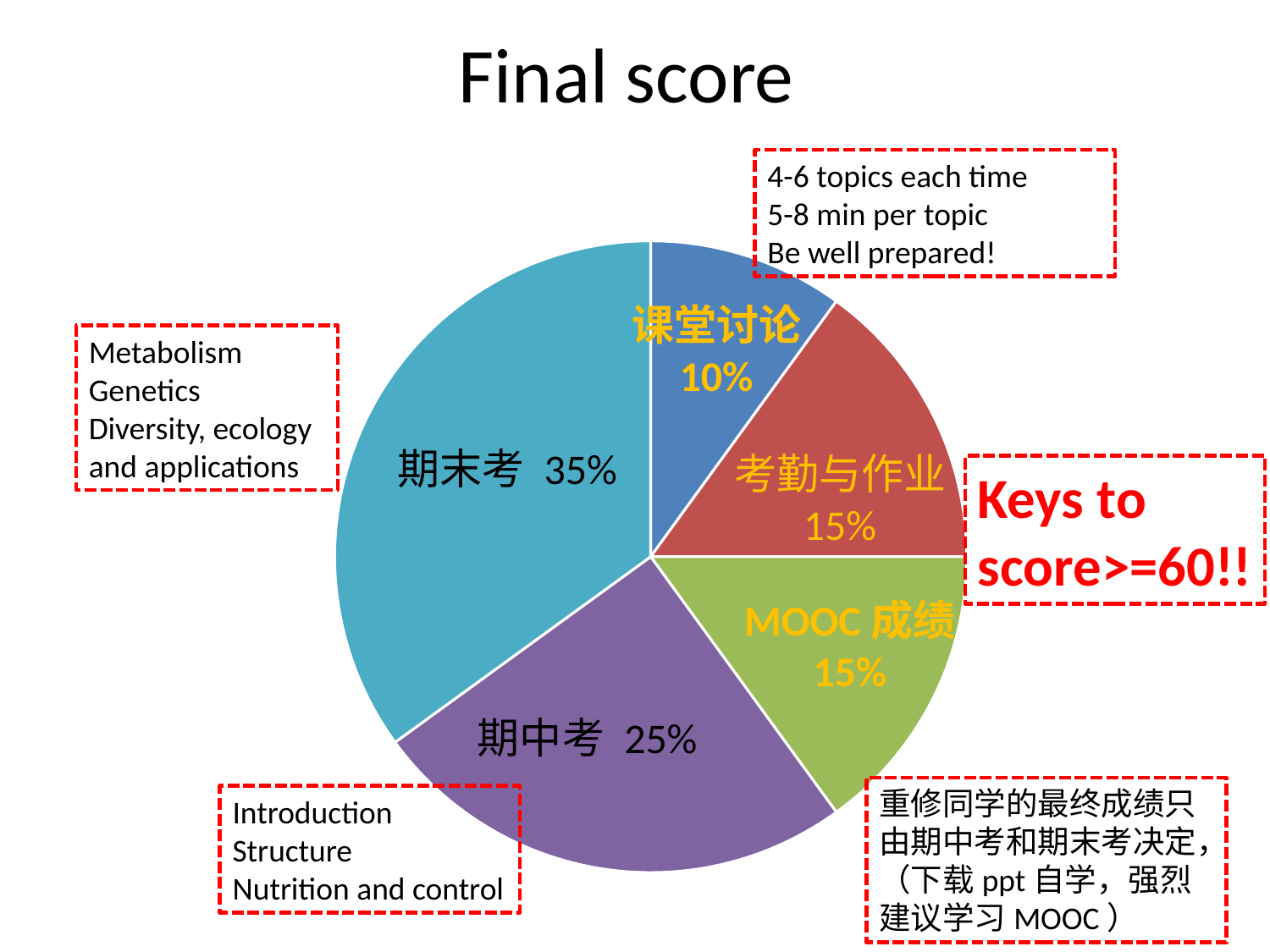
What is the difference in percentage points between 期末考 and 期中考? 10 What percentage does the MOOC 成绩 slice represent? 15% What percentage does the 期中考 slice represent? 25% What kind of chart is shown on the slide? pie chart What percentage does the 期末考 slice represent? 35% What colour is the 期中考 slice? purple How many slices does the pie chart have? 5 Which slice is the smallest in the pie chart? 课堂讨论 Which is larger, the 考勤与作业 slice or the 课堂讨论 slice? 考勤与作业 What is the title of the chart? Final score Which slice is the largest in the pie chart? 期末考 What percentage does the 课堂讨论 slice represent? 10%